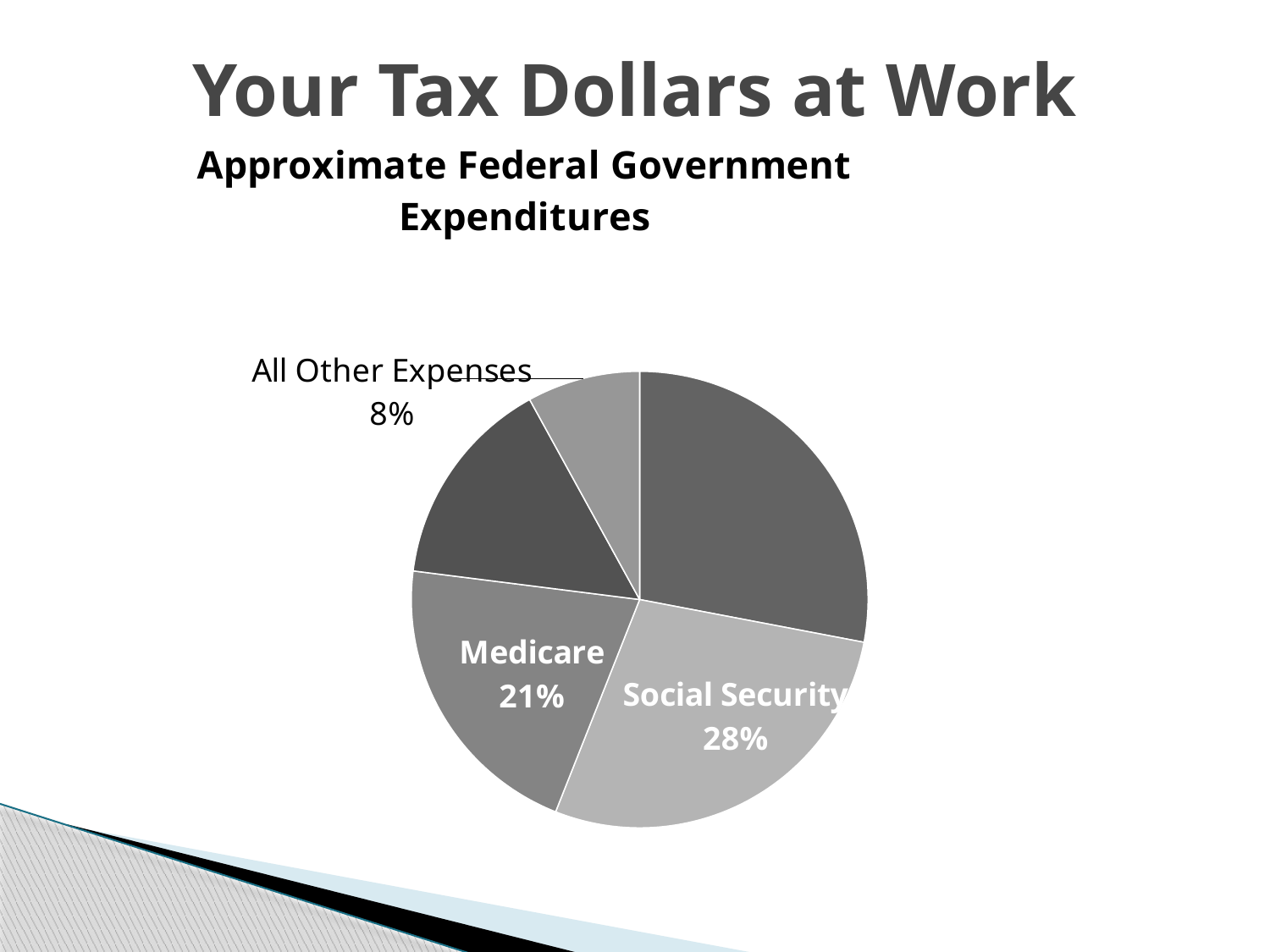
What percentage of expenditures does Social Security account for in the pie chart? 28% What share of the pie is labelled All Other Expenses? 8% What is the difference in percentage points between Social Security and Medicare? 7% Which is larger, the Medicare slice or the All Other Expenses slice? Medicare What percentage of expenditures does Medicare account for in the pie chart? 21% What is the title of the chart? Approximate Federal Government Expenditures What kind of chart is shown on the slide? Pie chart What is the difference in percentage points between Medicare and All Other Expenses? 13% Which labelled slice of the pie chart is the smallest? All Other Expenses Which is larger, the Social Security slice or the Medicare slice? Social Security How many slices does the pie chart have? 5